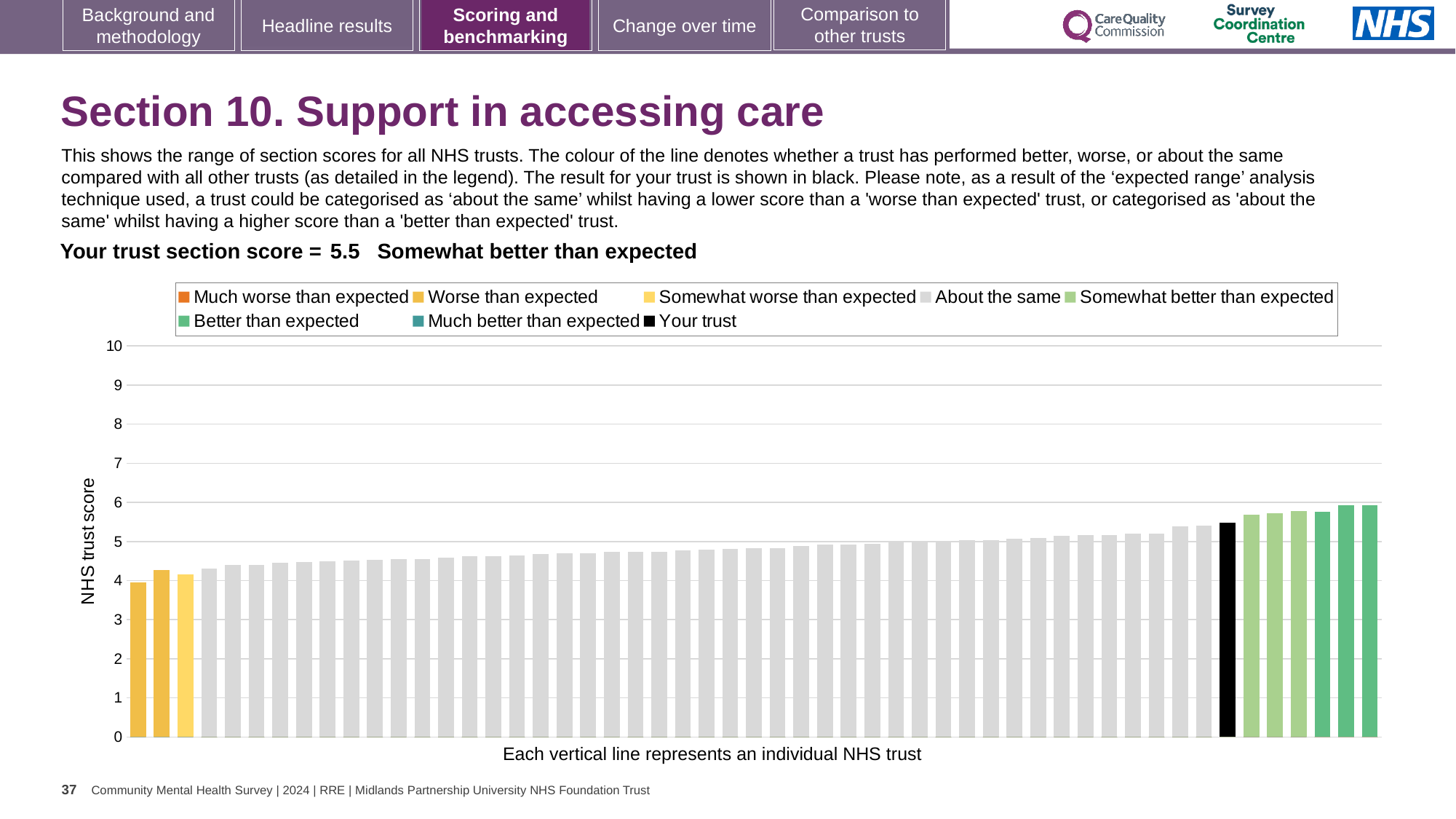
Is the value of the black bar (your trust) greater or less than 6? less Which legend category is your trust's score classified as? Somewhat better than expected Is the value of the leftmost bar greater or less than 5? less Do the bar values rise or fall from left to right along the x axis? rise What is the title of the vertical axis? NHS trust score Is the value of the black bar (your trust) greater or less than 5? greater How many entries does the chart legend list? 8 What is the section score for your trust? 5.5 What kind of chart is shown on the slide? bar chart